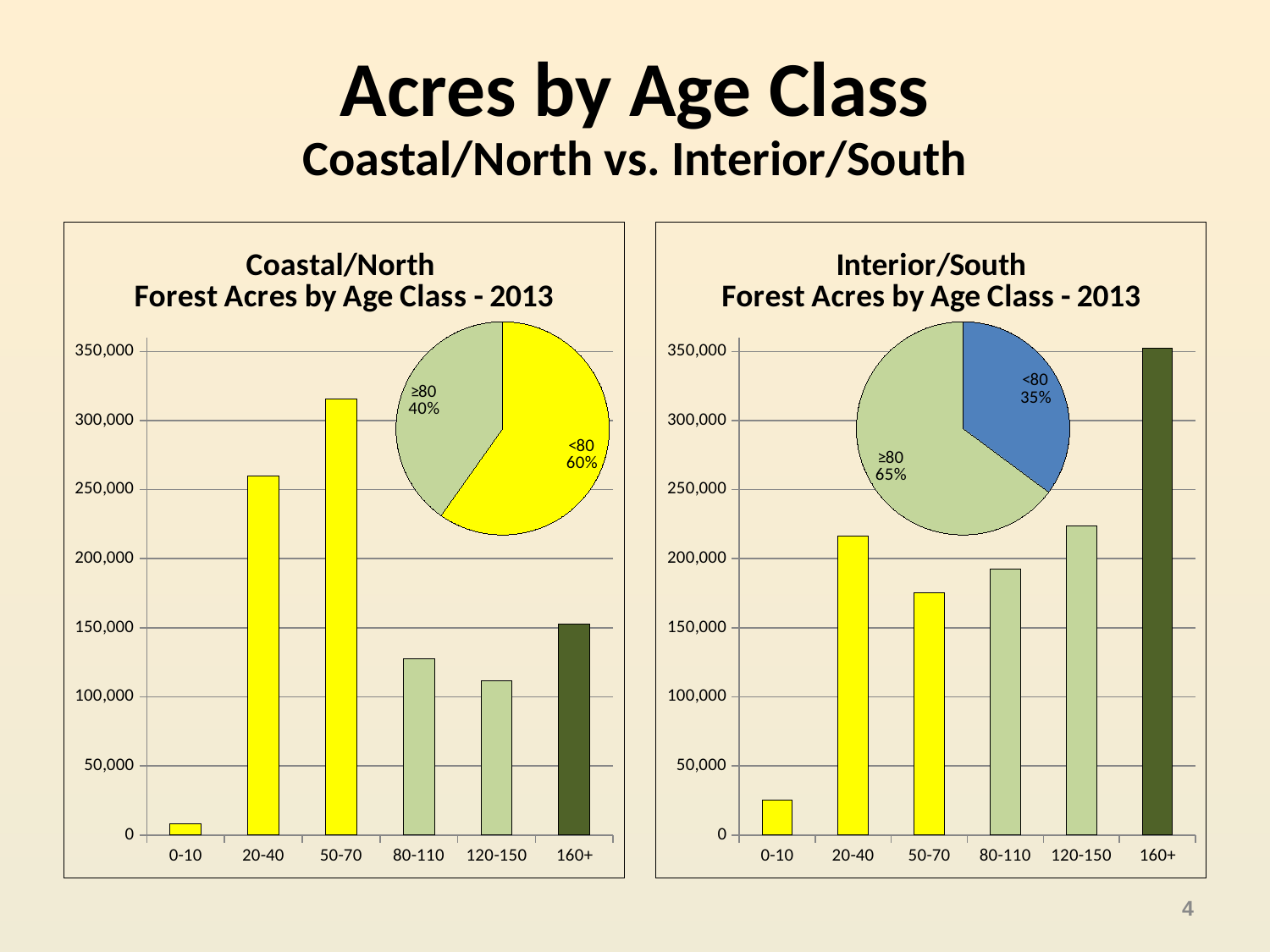
In the Interior/South chart, which age class has the highest number of forest acres? 160+ How many age class categories are shown on the x axis of the Interior/South chart? 6 In the Coastal/North pie chart, what share of acres is in the <80 age group? 60% In the Coastal/North chart, which age class has the lowest number of forest acres? 0-10 In the Interior/South chart, which age class has more acres: 120-150 or 50-70? 120-150 In the Interior/South chart, is the value for the 20-40 age class greater or less than 200,000? greater In the Coastal/North chart, which age class has the highest number of forest acres? 50-70 In the Coastal/North chart, is the value for the 120-150 age class greater or less than 150,000? less In the Interior/South chart, which age class has the lowest number of forest acres? 0-10 In the Interior/South pie chart, what share of acres is in the ≥80 age group? 65% In the Coastal/North chart, which age class has more acres: 20-40 or 80-110? 20-40 In the Coastal/North chart, is the value for the 50-70 age class greater or less than 300,000? greater